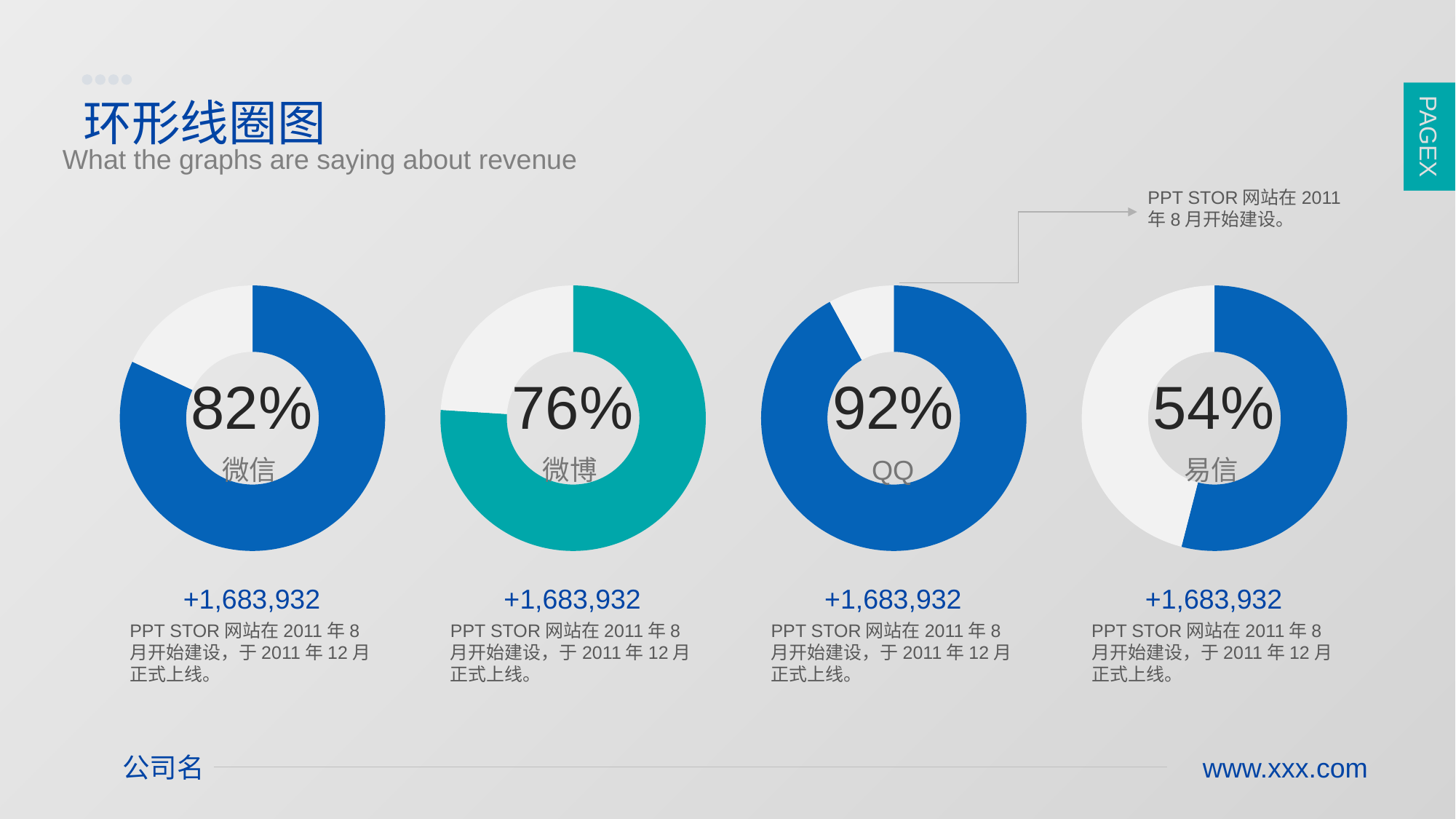
What colour is the filled portion of the 微博 donut chart? Teal What percentage is shown in the centre of the 微信 donut chart? 82% What percentage is shown in the centre of the 易信 donut chart? 54% How many donut charts are shown on the slide? 4 Which shows a larger percentage, the 微信 donut chart or the 微博 donut chart? 微信 What number is printed below the QQ donut chart? +1,683,932 Across the four donut charts on the slide, which one shows the lowest percentage? 易信 What percentage is shown in the centre of the 微博 donut chart? 76% What kind of chart is used for the 微信, 微博, QQ and 易信 figures on the slide? Donut chart What percentage is shown in the centre of the QQ donut chart? 92% What is the difference between the percentage in the QQ donut chart and the percentage in the 易信 donut chart? 38% Across the four donut charts on the slide, which one shows the highest percentage? QQ